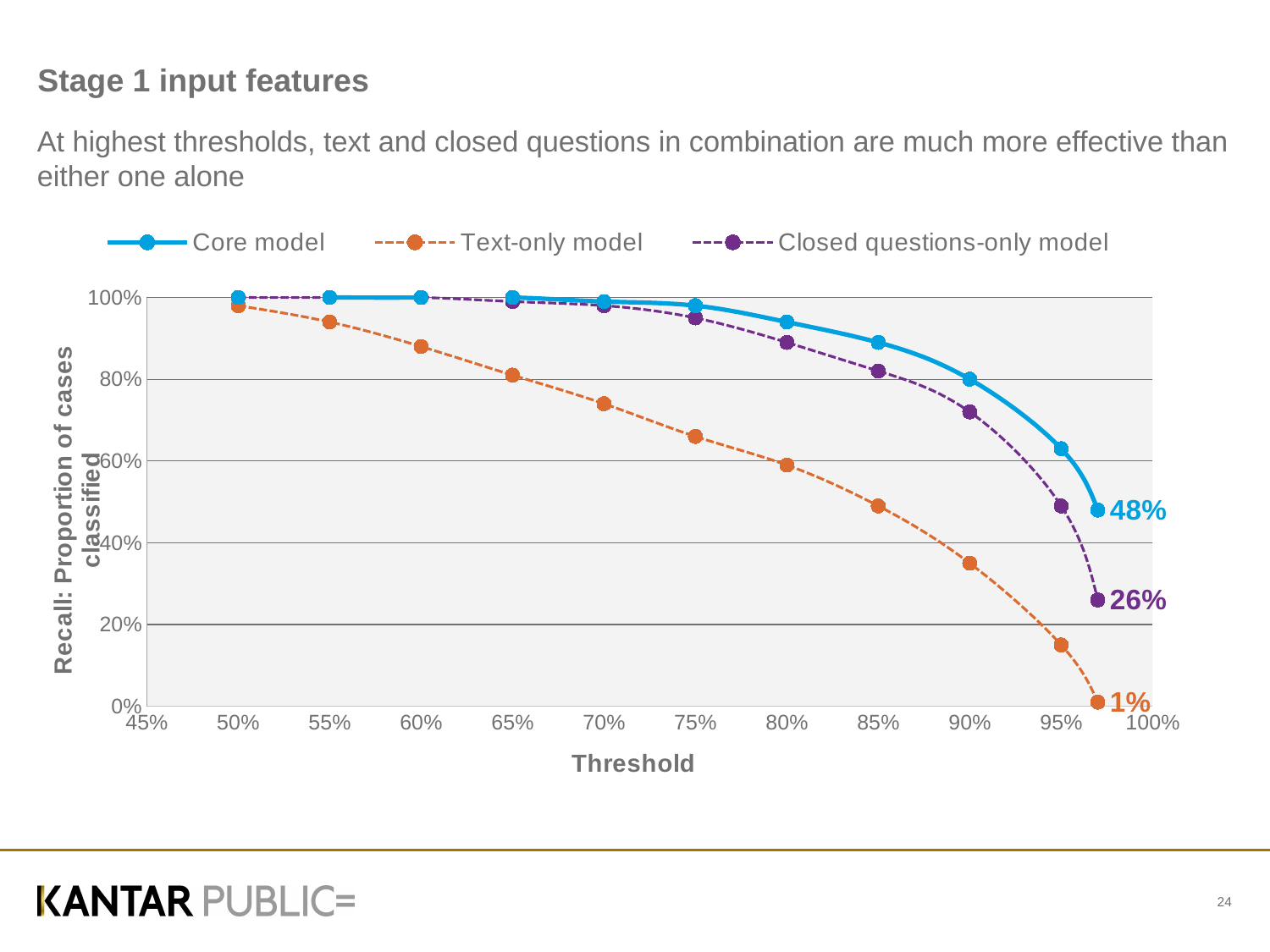
How many series does the legend list? 3 What is the labelled final value for the Text-only model? 1% Is the Text-only model's value at the 95% threshold greater or less than 20%? less Is the Text-only model's value at the 70% threshold greater or less than 60%? greater What is the labelled final value for the Core model? 48% What kind of chart is shown on the slide? Line chart What is the difference between the labelled final values of the Core model and the Closed questions-only model? 22 percentage points Which model has the lowest labelled value at the end of the curves? Text-only model Is the Closed questions-only model's value at the 90% threshold greater or less than 60%? greater What is the labelled final value for the Closed questions-only model? 26% Do the recall values rise or fall as the threshold increases along the x axis? Fall Which model has the highest labelled value at the end of the curves? Core model